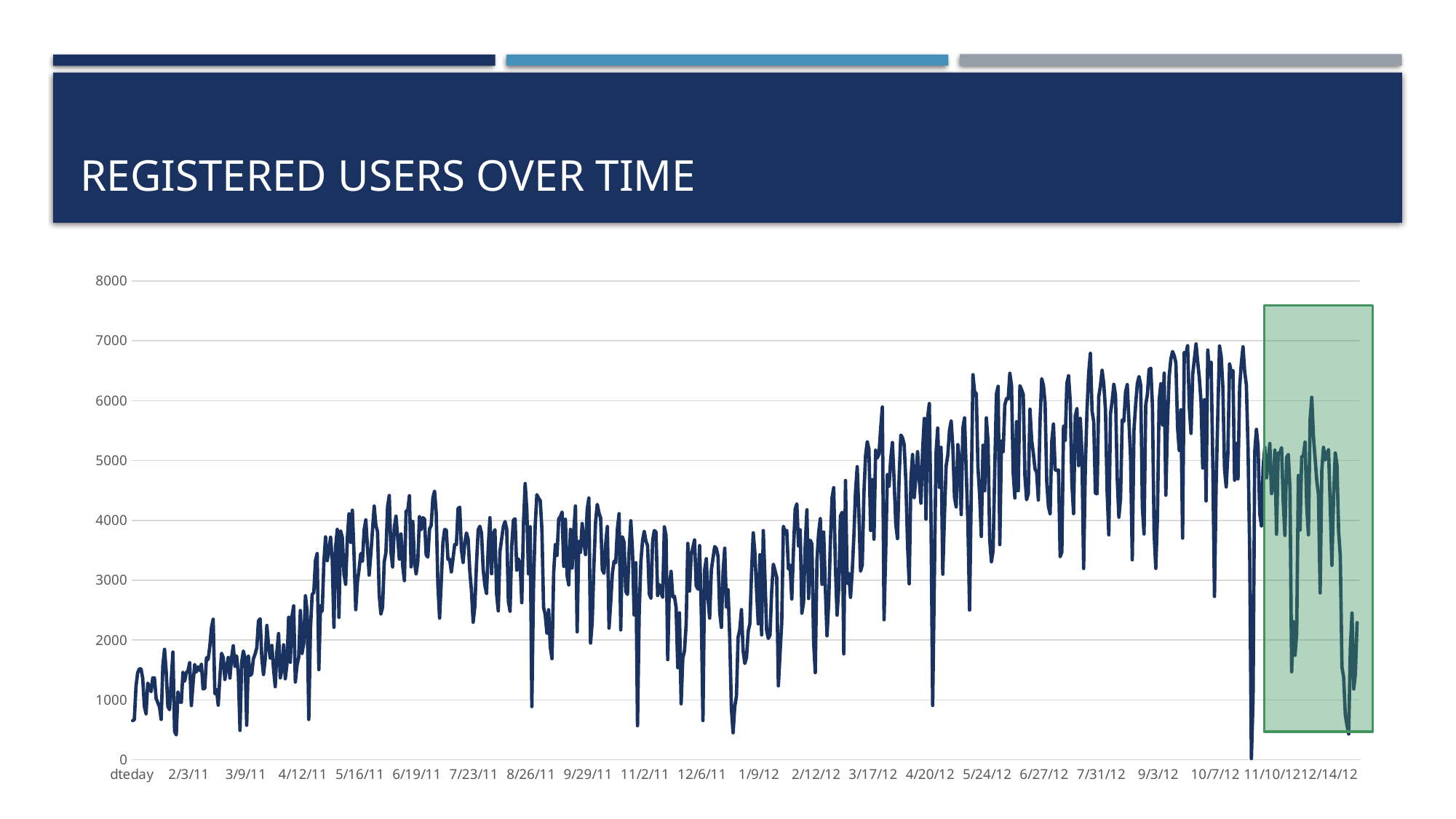
What is the highest value shown on the y axis? 8000 What is the first date label shown on the x axis after 'dteday'? 2/3/11 Which period has higher values: around 4/12/11 or around 7/31/12? around 7/31/12 What label appears at the start of the x axis? dteday Is the value around 2/3/11 greater or less than 3000? less What kind of chart is shown on the slide? line chart Are the values around 3/9/11 greater or less than 4000? less Overall, do the values rise or fall from the start of 2011 to late 2012? rise Is the lowest point of the line, near 11/10/12, greater or less than 1000? less